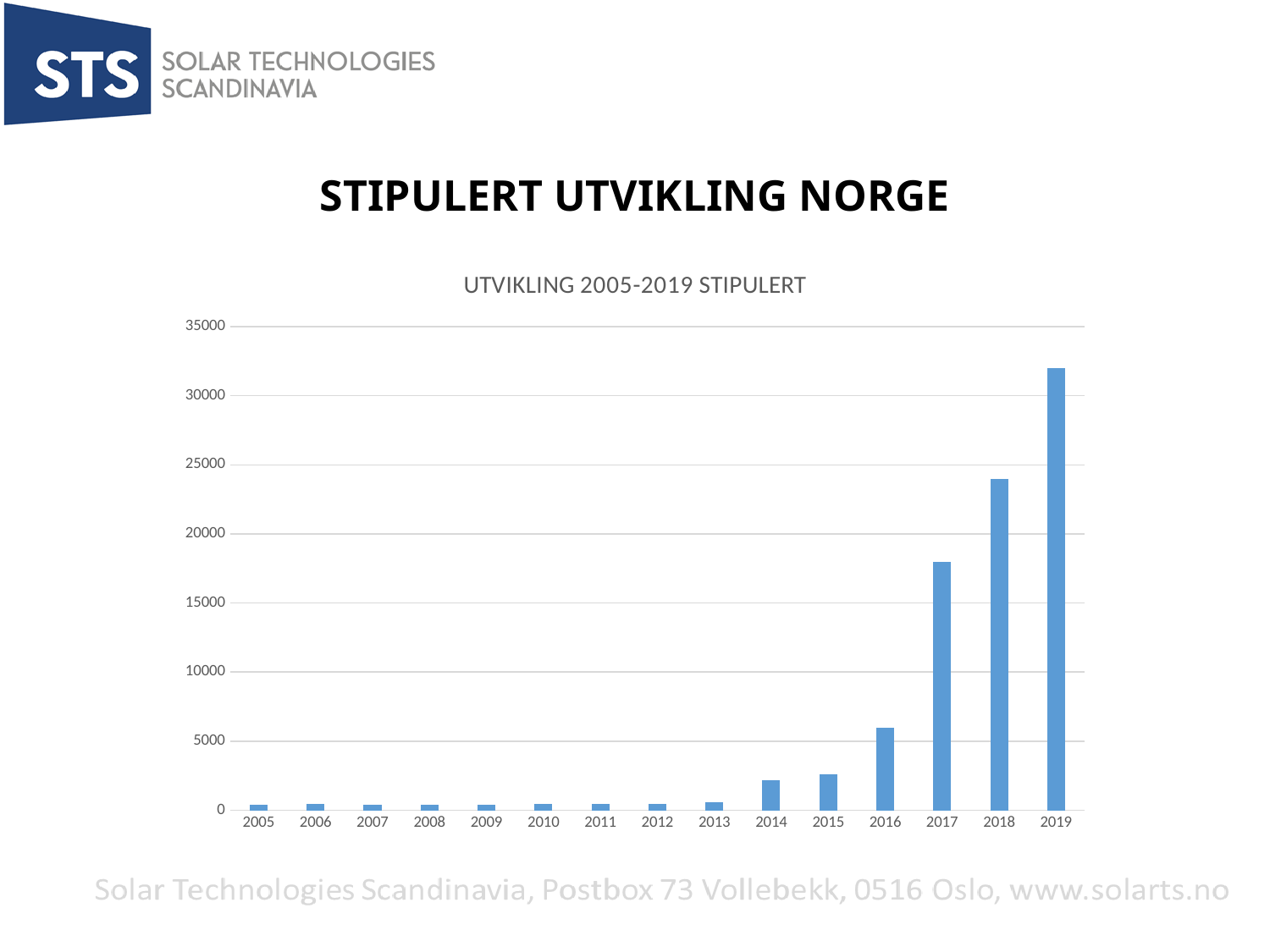
What kind of chart is shown on the slide? bar chart How many years are shown on the x axis of the chart? 15 Is the value for 2019 greater or less than 30000? greater Is the value for 2015 greater or less than 5000? less Do the values generally rise or fall from 2005 to 2019? rise What is the title of the chart? UTVIKLING 2005-2019 STIPULERT Is the value for 2016 greater or less than 5000? greater Which year has the highest value in the chart? 2019 Which is larger, the value for 2016 or the value for 2014? 2016 Which is larger, the value for 2018 or the value for 2017? 2018